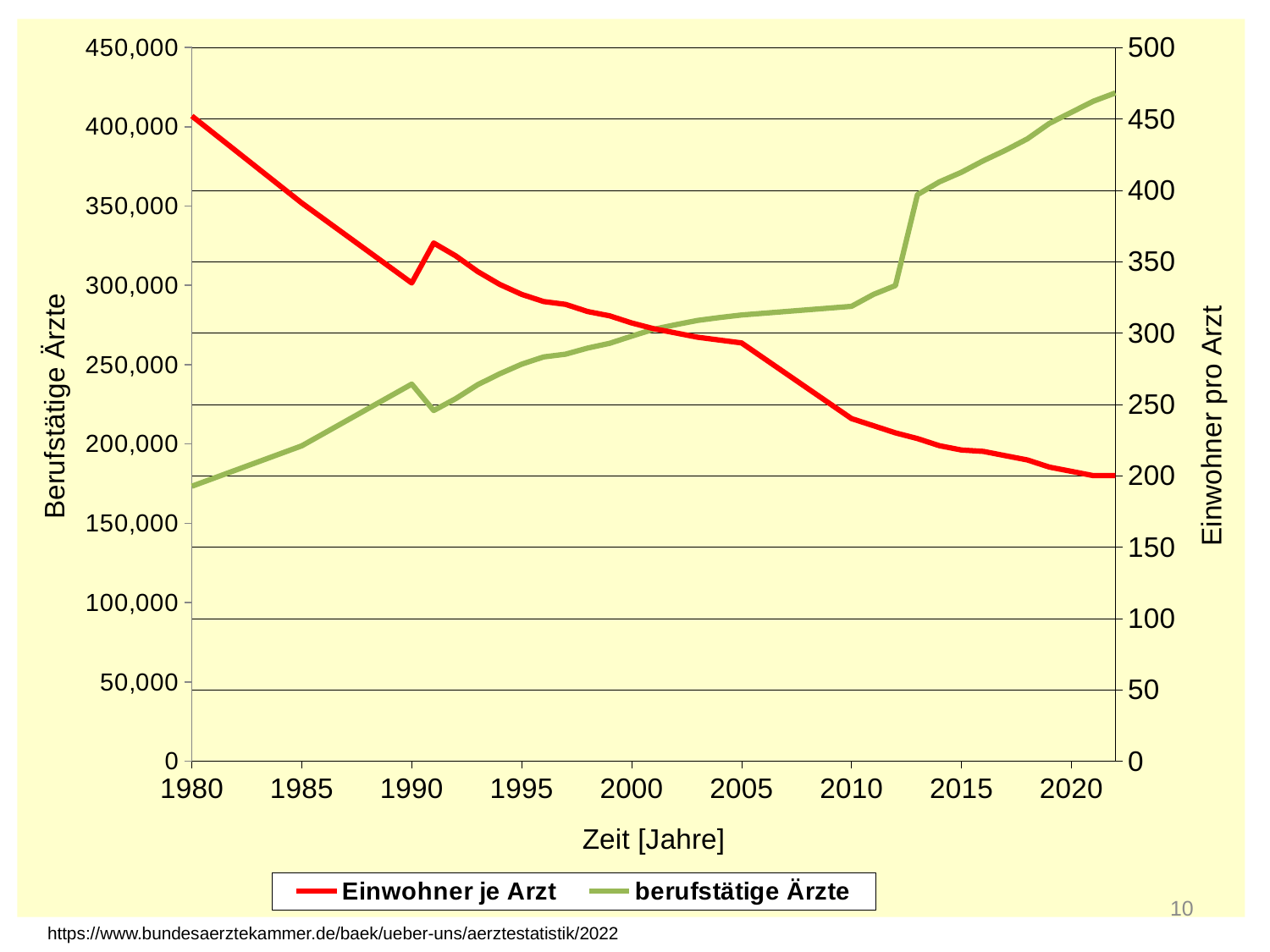
What is the title of the x axis? Zeit [Jahre] Is the value for Einwohner je Arzt in 1980 greater or less than 400 on the right axis? greater Is the value for berufstätige Ärzte in 1980 greater or less than 200,000 on the left axis? less Does the Einwohner je Arzt line rise or fall from 1980 to 2020? fall What kind of chart is shown on the slide? line chart Which series is drawn in red? Einwohner je Arzt Is the value for Einwohner je Arzt in 2010 greater or less than 200 on the right axis? greater Does the berufstätige Ärzte line rise or fall from 1980 to 2020? rise How many series does the legend list? 2 How many year labels are shown on the x axis? 9